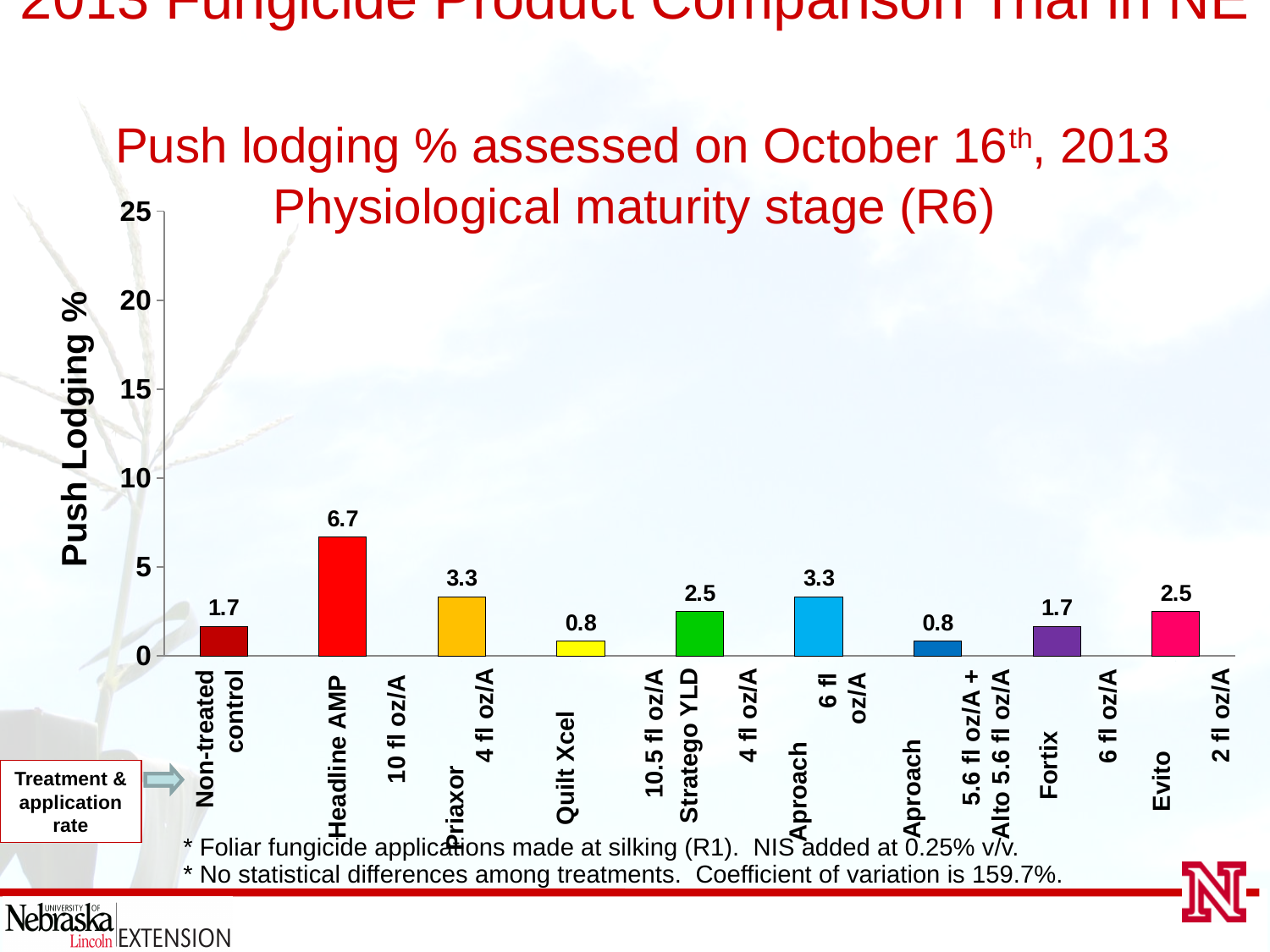
What type of chart is shown on the slide? Bar chart Is the push lodging % for Headline AMP greater or less than 5? greater Which has a higher push lodging %, Stratego YLD or Fortix? Stratego YLD How many treatments are plotted on the chart? 9 What is the label of the y-axis? Push Lodging % What is the push lodging % for Quilt Xcel? 0.8 What is the push lodging % for Headline AMP? 6.7 What is the difference in push lodging % between Headline AMP and Priaxor? 3.4 Which treatment has the highest push lodging %? Headline AMP What is the lowest push lodging % value shown on the chart? 0.8 What is the push lodging % for the Non-treated control? 1.7 What is the push lodging % for Evito? 2.5